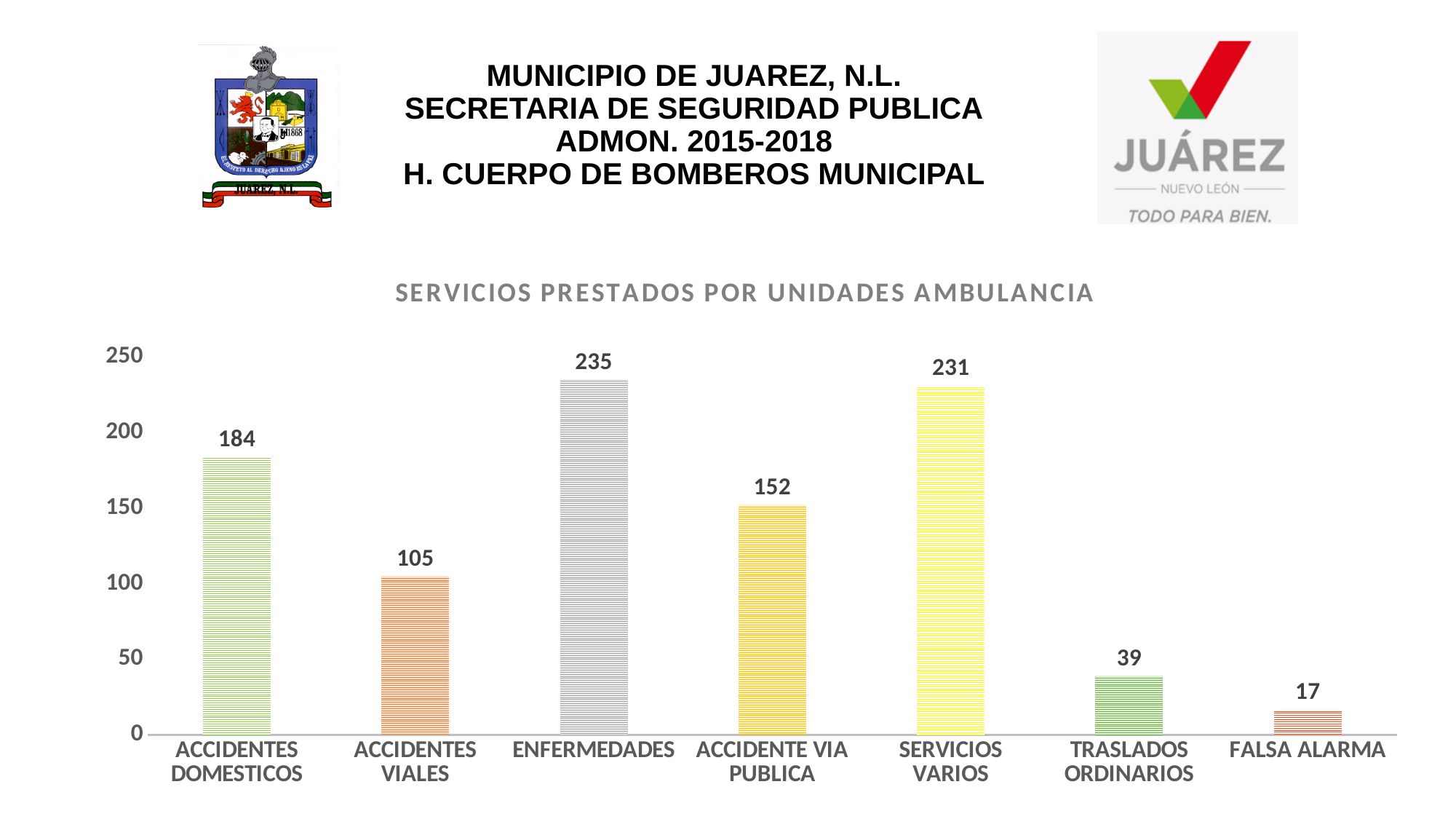
What is the difference between the values for SERVICIOS VARIOS and FALSA ALARMA? 214 What is the value for TRASLADOS ORDINARIOS? 39 Is the value for ACCIDENTES VIALES greater or less than 100? greater What is the difference between the values for ACCIDENTES DOMESTICOS and ACCIDENTE VIA PUBLICA? 32 What is the value for ENFERMEDADES? 235 How many categories are shown on the x axis? 7 What kind of chart is shown on the slide? bar chart Which category has the lowest value? FALSA ALARMA What is the value for ACCIDENTES VIALES? 105 Which category has the highest value? ENFERMEDADES Which is larger, the value for ACCIDENTES DOMESTICOS or the value for ACCIDENTE VIA PUBLICA? ACCIDENTES DOMESTICOS What is the title of the chart? SERVICIOS PRESTADOS POR UNIDADES AMBULANCIA